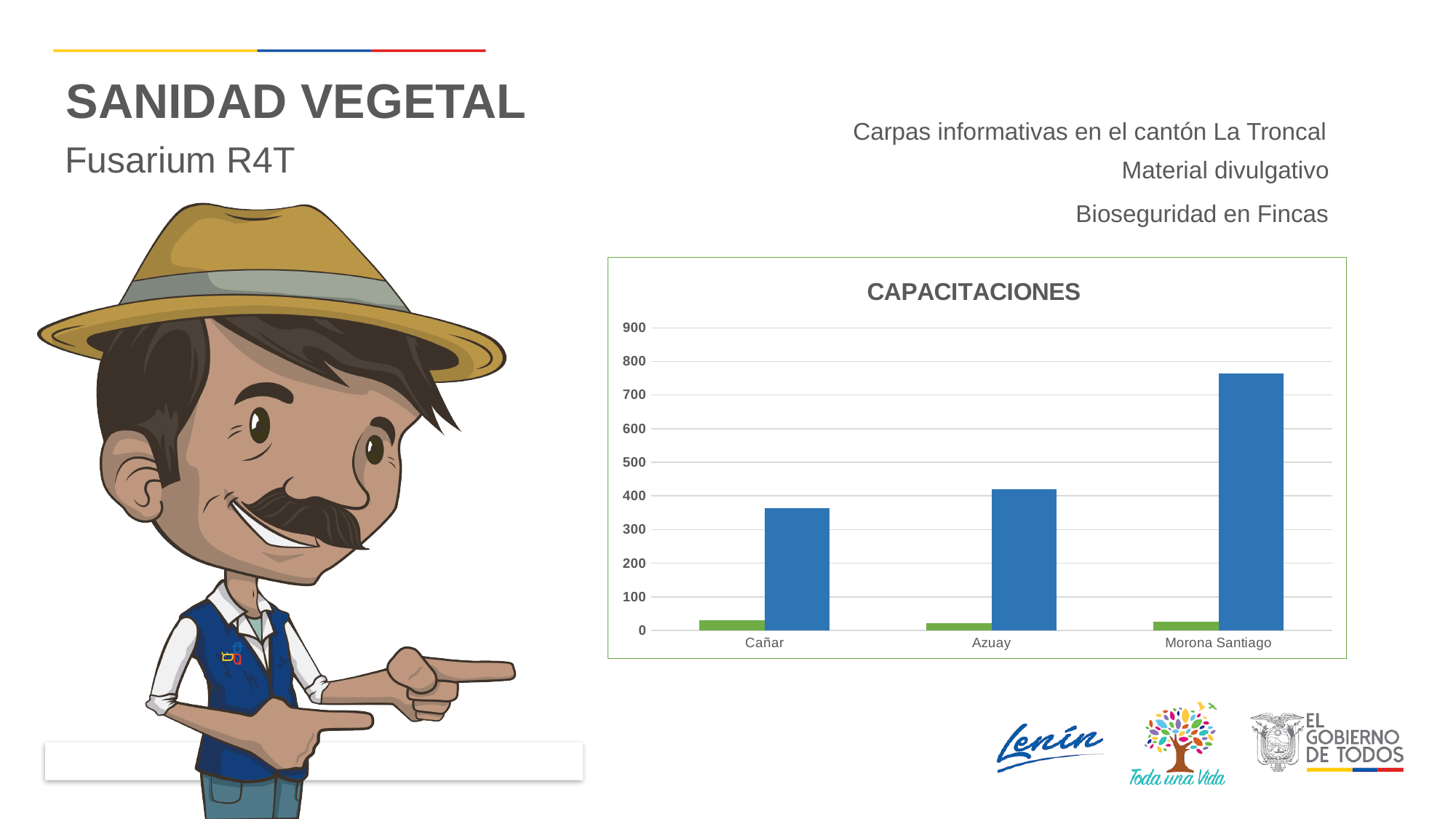
What kind of chart is shown on the slide? bar chart Which category has the tallest blue bar in the chart? Morona Santiago Which category has the shortest blue bar in the chart? Cañar Is the blue bar for Morona Santiago greater or less than 700? greater Is the green bar for Cañar greater or less than 100? less Is the blue bar for Azuay greater or less than 500? less Which has a larger blue bar, Azuay or Cañar? Azuay What is the title of the chart on the slide? CAPACITACIONES How many categories are shown on the x axis of the chart? 3 Do the blue bars rise or fall from Cañar to Morona Santiago along the x axis? rise What two colours are used for the bars in the chart? green and blue